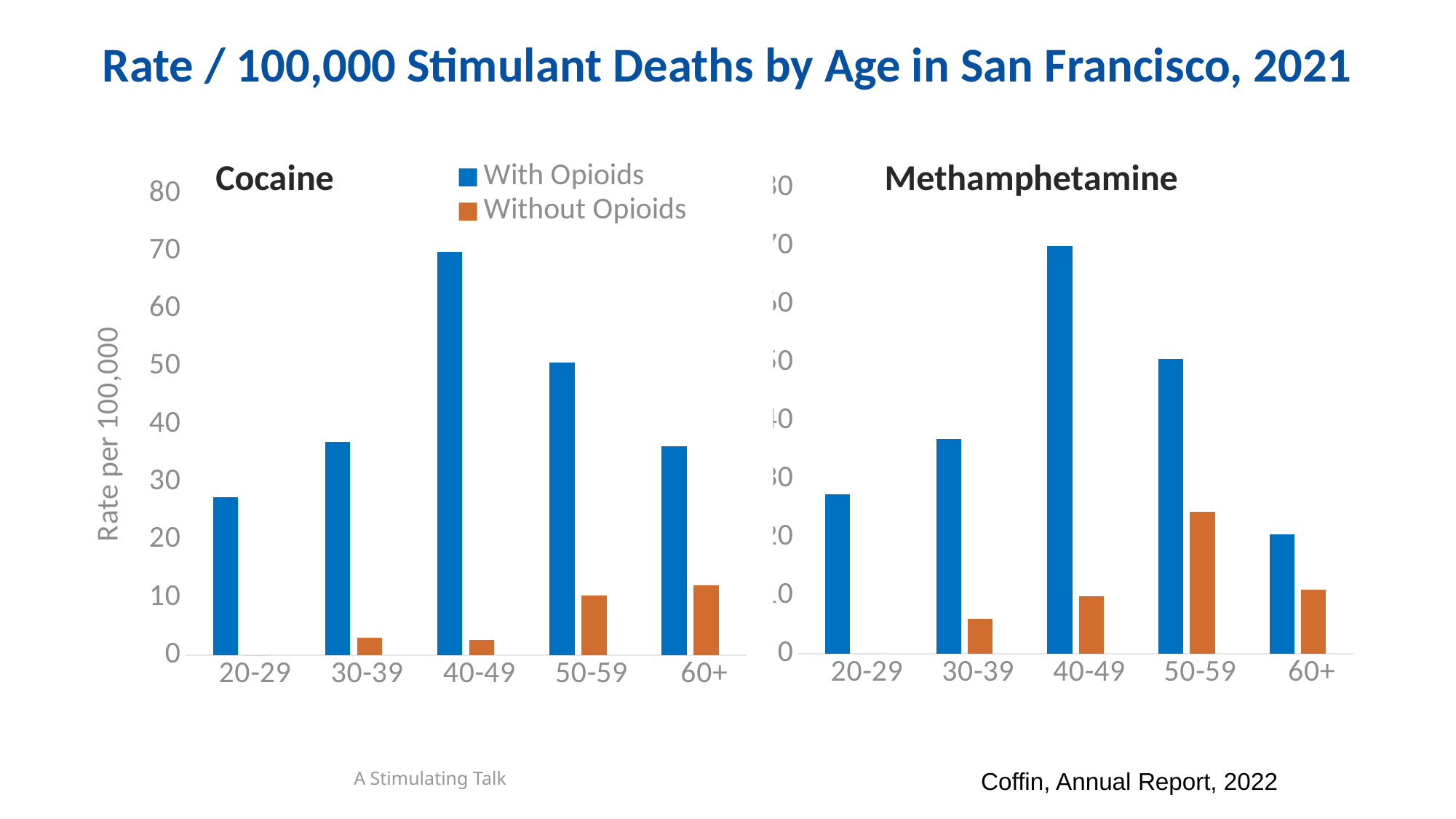
In the Methamphetamine chart, which age group has the lowest With Opioids rate? 60+ In the Methamphetamine chart, which age group has the highest With Opioids rate? 40-49 In the Methamphetamine chart, which age group has the highest Without Opioids rate? 50-59 In the Cocaine chart, which age group has the highest With Opioids rate? 40-49 Which colour represents the Without Opioids series? orange In the Cocaine chart, is the Without Opioids value for 50-59 greater or less than 20? less In the Cocaine chart, is the With Opioids value for 40-49 greater or less than 60? greater How many series does the legend list? 2 In the Methamphetamine chart, is the With Opioids value for 60+ greater or less than 30? less What kind of chart is the Cocaine chart? bar chart How many age categories are shown on the Methamphetamine chart? 5 In the Cocaine chart, which is larger for the 50-59 age group: With Opioids or Without Opioids? With Opioids